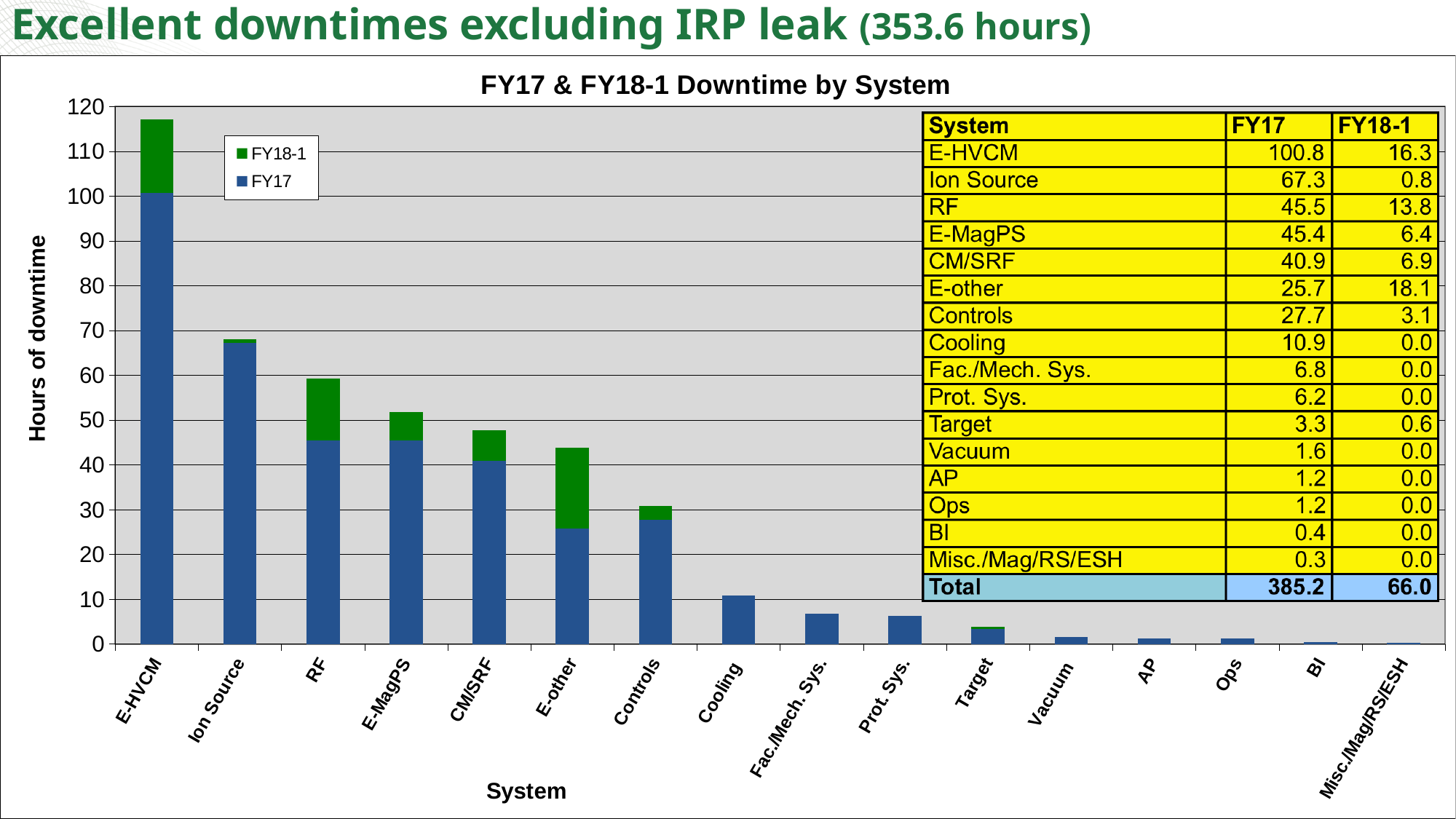
What is the total downtime (FY17 plus FY18-1) for the E-HVCM bar? 117.1 What is the FY17 downtime for E-HVCM? 100.8 How many systems are plotted along the x axis of the chart? 16 Which system has the highest FY18-1 downtime? E-other Which system has the lowest FY17 downtime? Misc./Mag/RS/ESH What is the difference between the FY17 downtime for E-HVCM and for Ion Source? 33.5 What is the title of the chart? FY17 & FY18-1 Downtime by System Is the total height of the Ion Source bar greater or less than 60? greater What type of chart is shown on the slide? stacked bar chart What is the FY18-1 downtime for RF? 13.8 How many series does the chart legend list? 2 Which has the larger FY17 downtime, Controls or E-other? Controls